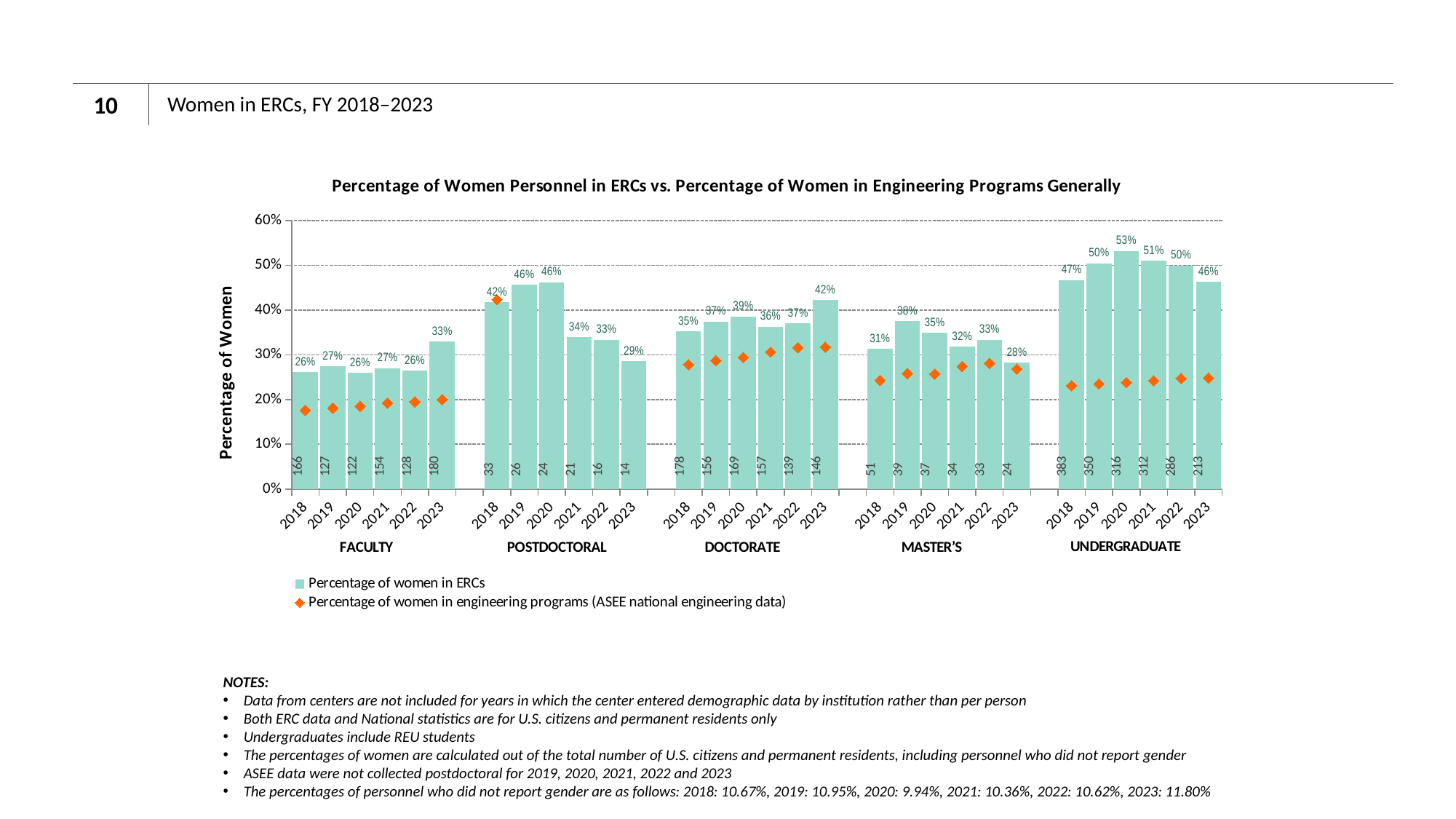
What is the percentage of women in ERCs for Faculty in 2023? 33% Which is larger, the Master's percentage of women in ERCs in 2019 or the Faculty percentage in 2019? Master's 2019 In which year is the Postdoctoral percentage of women in ERCs lowest? 2023 What is the percentage of women in ERCs for Undergraduate in 2020? 53% What number is printed inside the Undergraduate bar for 2018? 383 In which year is the Undergraduate percentage of women in ERCs highest? 2020 Do the Undergraduate percentages of women in ERCs rise or fall from 2018 to 2020? rise What is the difference between the Doctorate percentage of women in ERCs in 2023 and in 2018? 7 percentage points How many years are shown for each personnel group? 6 Is the orange diamond value (ASEE national engineering data) for Undergraduate in 2023 greater or less than 20%? greater Is the orange diamond value (ASEE national engineering data) for Faculty in 2018 greater or less than 20%? less How many series does the legend list? 2